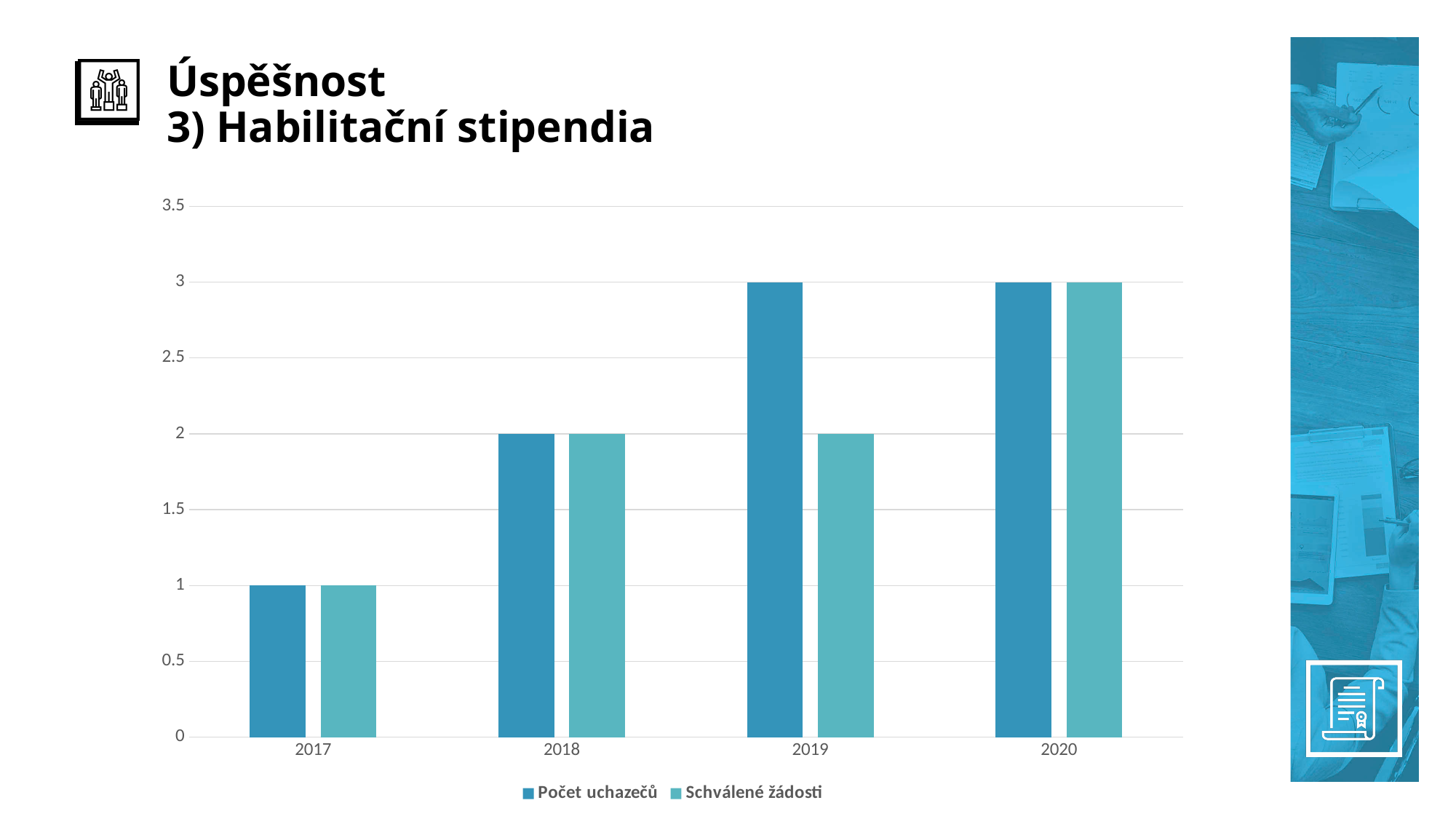
How many years are shown on the x axis? 4 What is the value of Počet uchazečů for 2017? 1 What is the value of Schválené žádosti for 2020? 3 Which series is shown in the darker blue colour? Počet uchazečů Does Počet uchazečů rise or fall from 2017 to 2019? rise What is the value of Schválené žádosti for 2019? 2 What is the value of Počet uchazečů for 2019? 3 What kind of chart is shown on the slide? bar chart What is the difference between Počet uchazečů and Schválené žádosti in 2019? 1 Which year has the lowest value of Počet uchazečů? 2017 How many series does the legend list? 2 Which year has the highest value of Schválené žádosti? 2020